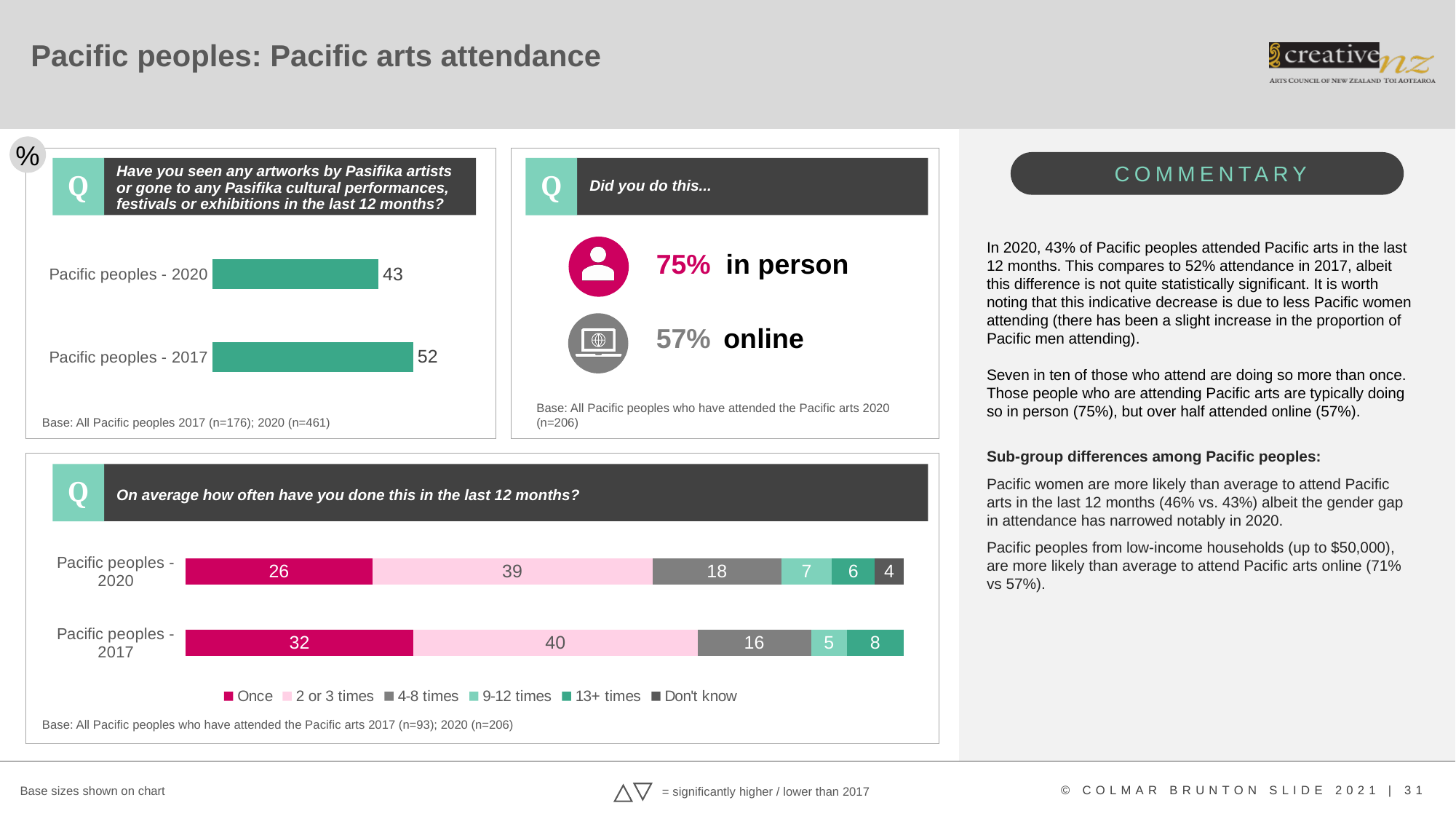
In the top-left chart on Pasifika arts attendance, which year has the higher value, 2020 or 2017? 2017 In the bottom chart on how often people attended in the last 12 months, how many series does the legend list? 6 In the top-left chart on Pasifika arts attendance, what is the value for Pacific peoples - 2017? 52 What type of chart is the top-left chart on Pasifika arts attendance? Bar chart In the top-left chart on Pasifika arts attendance, what is the difference between the 2017 and 2020 values? 9 In the bottom chart on how often people attended in the last 12 months, what is the total of the stacked bar for Pacific peoples - 2020? 100 In the bottom chart on how often people attended in the last 12 months, which category has the largest value for Pacific peoples - 2020? 2 or 3 times In the bottom chart on how often people attended in the last 12 months, what is the value for '2 or 3 times' for Pacific peoples - 2017? 40 In the top-left chart on Pasifika arts attendance, what is the value for Pacific peoples - 2020? 43 In the bottom chart on how often people attended in the last 12 months, what is the difference between the 'Once' values for 2017 and 2020? 6 In the bottom chart on how often people attended in the last 12 months, what is the value for '13+ times' for Pacific peoples - 2017? 8 In the bottom chart on how often people attended in the last 12 months, what is the value for 'Once' for Pacific peoples - 2020? 26